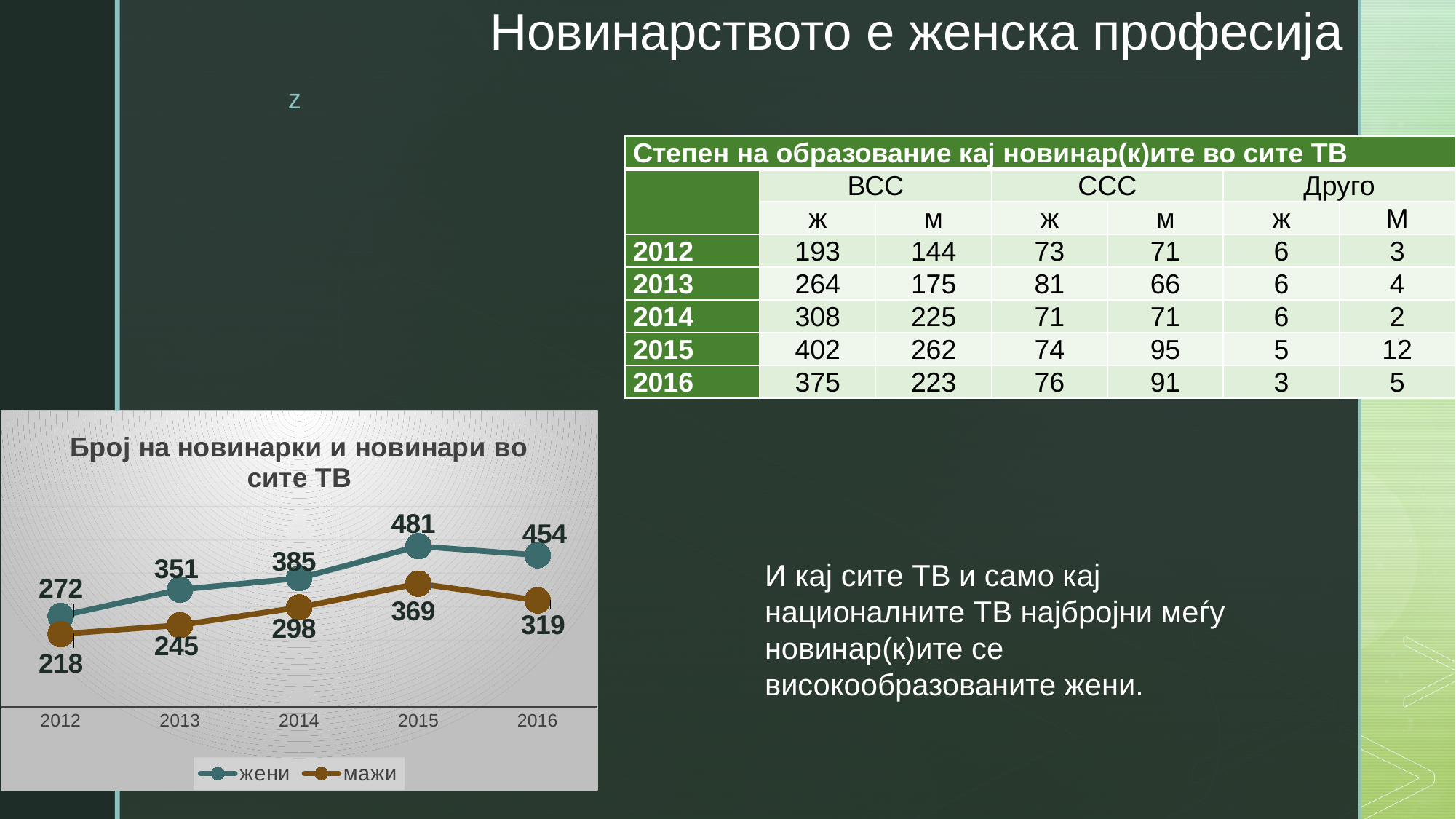
What is the value for жени in 2015? 481 In which year is the value for жени highest? 2015 Which is larger in 2014, the value for жени or for мажи? жени What is the title of the chart? Број на новинарки и новинари во сите ТВ What is the difference between the жени values for 2016 and 2012? 182 How many years are shown on the x axis? 5 What is the difference between жени and мажи in 2015? 112 In which year is the value for мажи lowest? 2012 What kind of chart is shown? line chart How many series does the legend list? 2 What is the value for мажи in 2012? 218 What is the value for мажи in 2016? 319